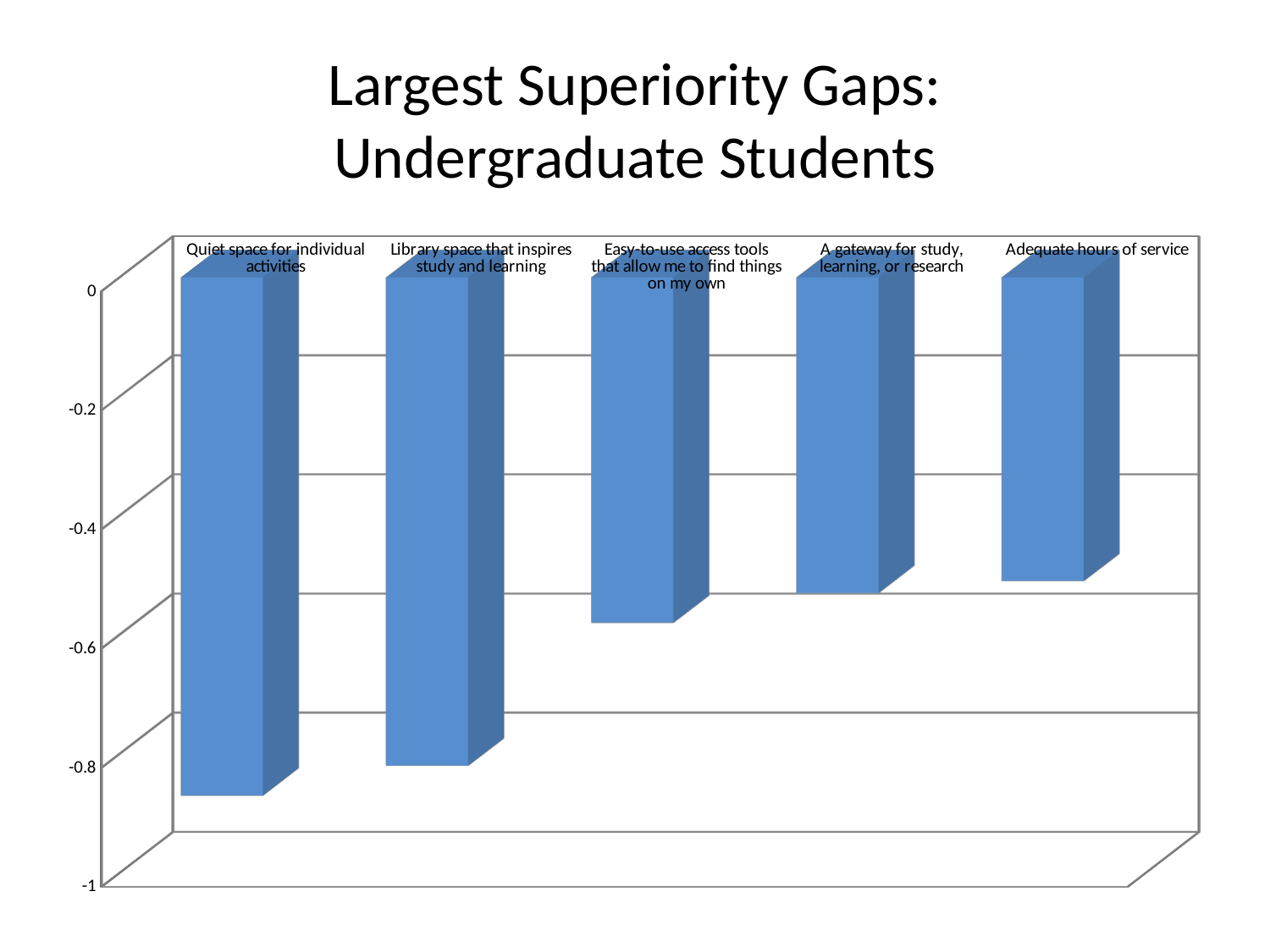
What kind of chart is shown on the slide? Bar chart Is the value for 'Library space that inspires study and learning' greater or less than -0.6? less How many categories are plotted in the chart? 5 Is the value for 'Quiet space for individual activities' greater or less than -0.8? less Is the value for 'Easy-to-use access tools that allow me to find things on my own' greater or less than -0.4? less Which has the larger (less negative) value: 'Quiet space for individual activities' or 'Easy-to-use access tools that allow me to find things on my own'? Easy-to-use access tools that allow me to find things on my own Do the values rise or fall moving from left to right along the x axis? Rise Which category has the lowest (most negative) value? Quiet space for individual activities What is the title of the chart on the slide? Largest Superiority Gaps: Undergraduate Students